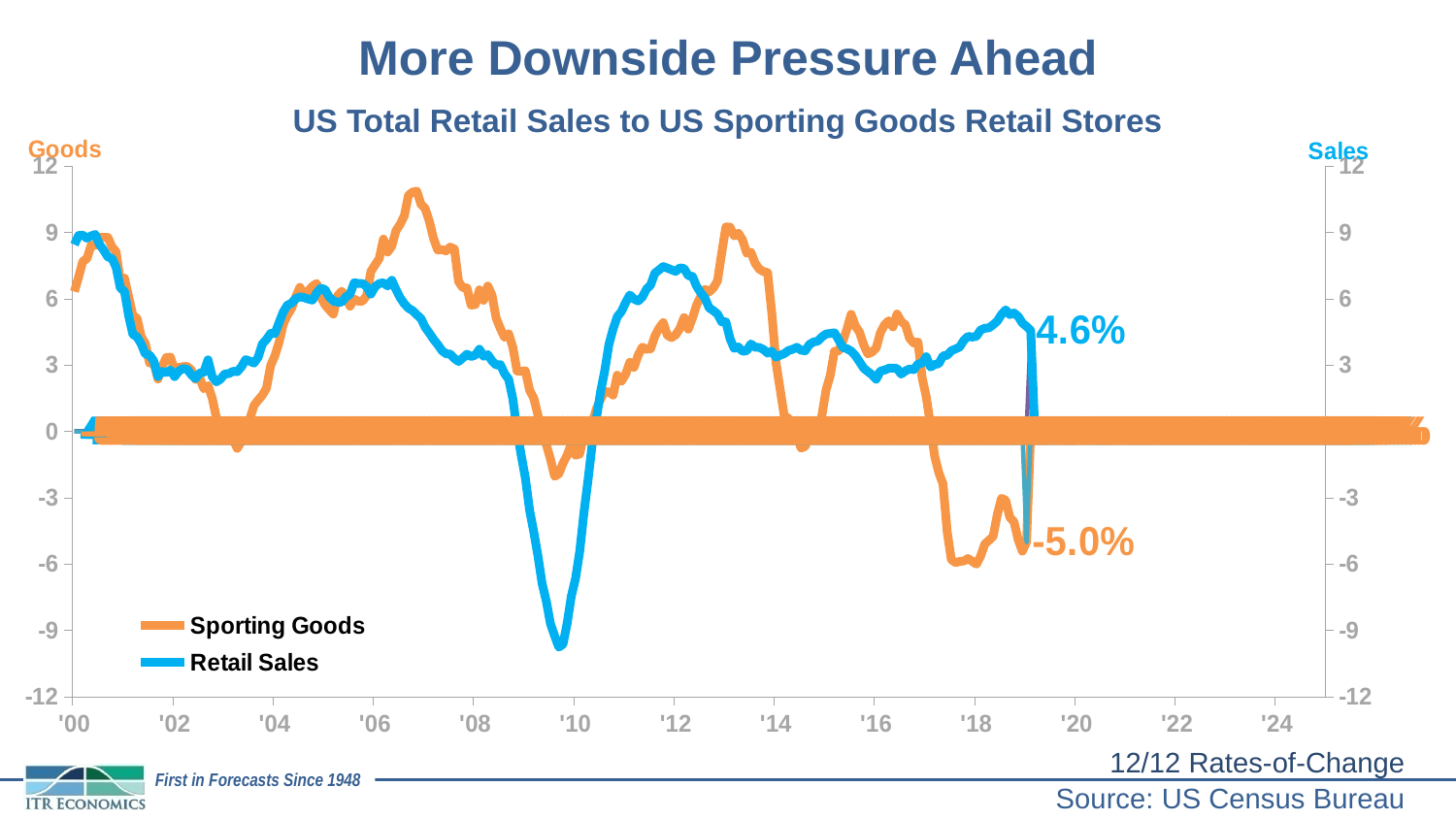
What are the two series named in the legend? Sporting Goods and Retail Sales How many series does the legend list? 2 What is the latest labeled value for the Sporting Goods series? -5.0% Is the highest point of the Sporting Goods line, around '07, greater or less than 9? greater Is the Sporting Goods value around '18 greater or less than -3? less What is the title of the chart below the slide heading? US Total Retail Sales to US Sporting Goods Retail Stores What type of chart is shown on the slide? line chart What is the difference between the latest labeled Retail Sales value (4.6%) and the latest labeled Sporting Goods value (-5.0%)? 9.6 percentage points Between '16 and '18, does the Sporting Goods line rise or fall? fall What is the latest labeled value for the Retail Sales series? 4.6% At the end of the plotted data, which series has the higher value, Retail Sales or Sporting Goods? Retail Sales Is the lowest point of the Retail Sales line, around '10, greater or less than -6? less